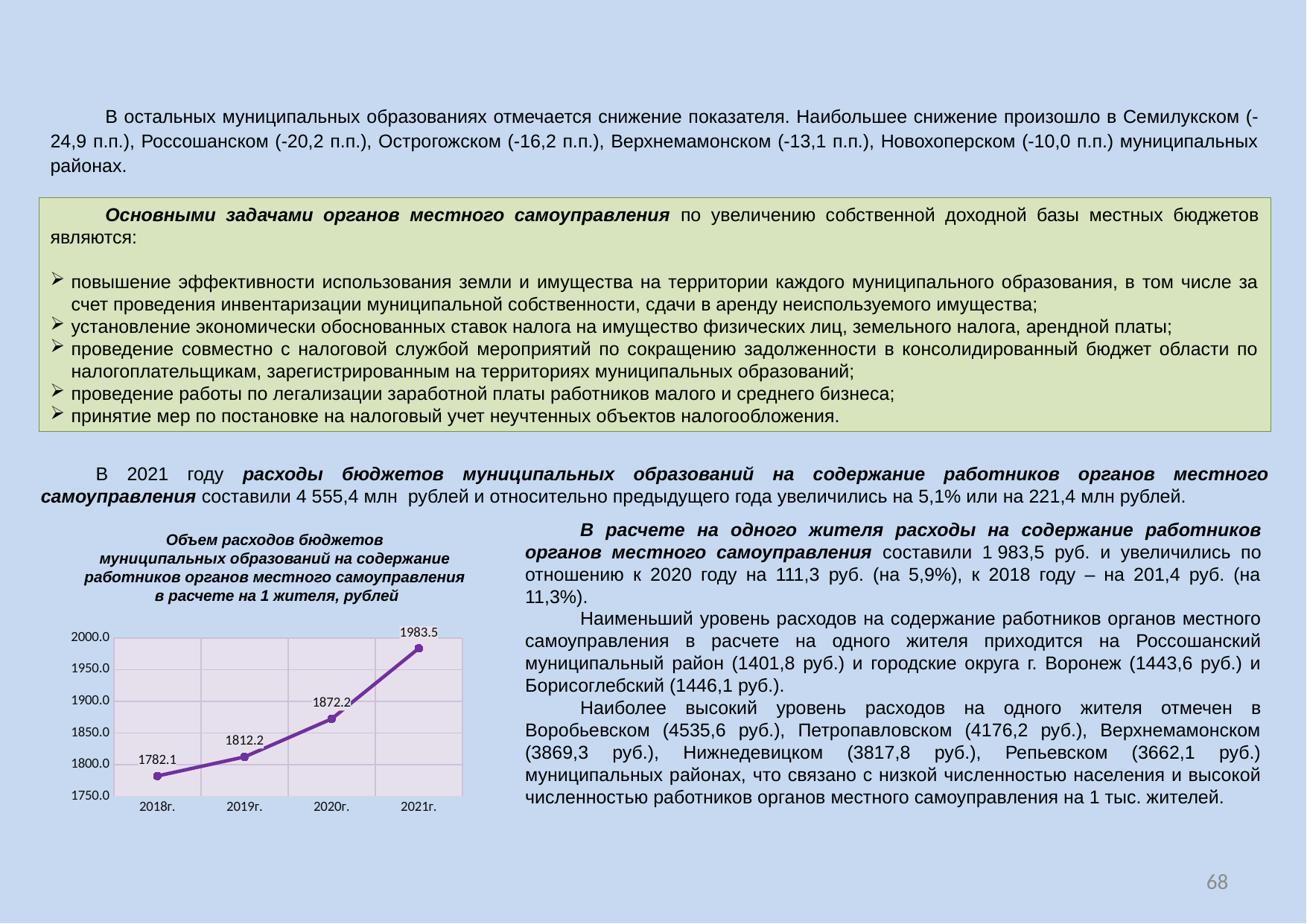
What is the value for 2021г. in the chart? 1983.5 What is the value for 2020г. in the chart? 1872.2 What type of chart is shown on the slide? line chart By how much did the value increase from 2020г. to 2021г.? 111.3 Which year has the highest value in the chart? 2021г. Is the value for 2020г. greater or less than 1850.0? greater Which year has the lowest value in the chart? 2018г. What is the difference between the values for 2021г. and 2018г.? 201.4 What is the value for 2018г. in the chart? 1782.1 What is the value for 2019г. in the chart? 1812.2 Do the values rise or fall from 2018г. to 2021г.? rise How many years (data points) are plotted in the chart? 4